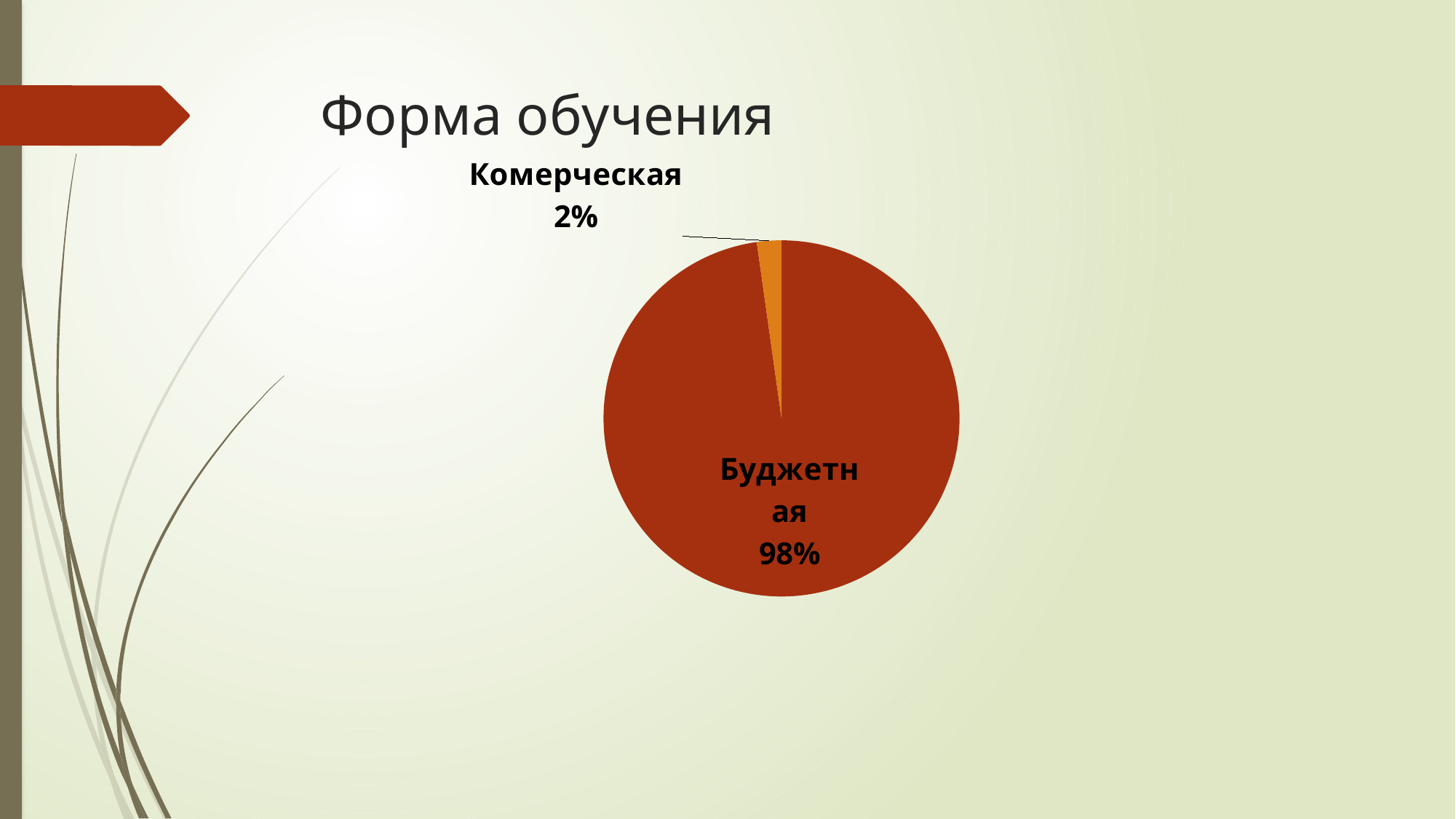
What colour is the Комерческая slice of the pie? orange What kind of chart is shown on the slide? pie chart What share of the pie does the Буджетная slice have? 98% What share of the pie does the Комерческая slice have? 2% Which slice of the pie is the largest? Буджетная Which slice of the pie is the smallest? Комерческая Which is larger, the Буджетная slice or the Комерческая slice? Буджетная What is the difference in percentage points between the Буджетная and Комерческая slices? 96 How many slices does the pie chart have? 2 What is the title of the slide containing the pie chart? Форма обучения